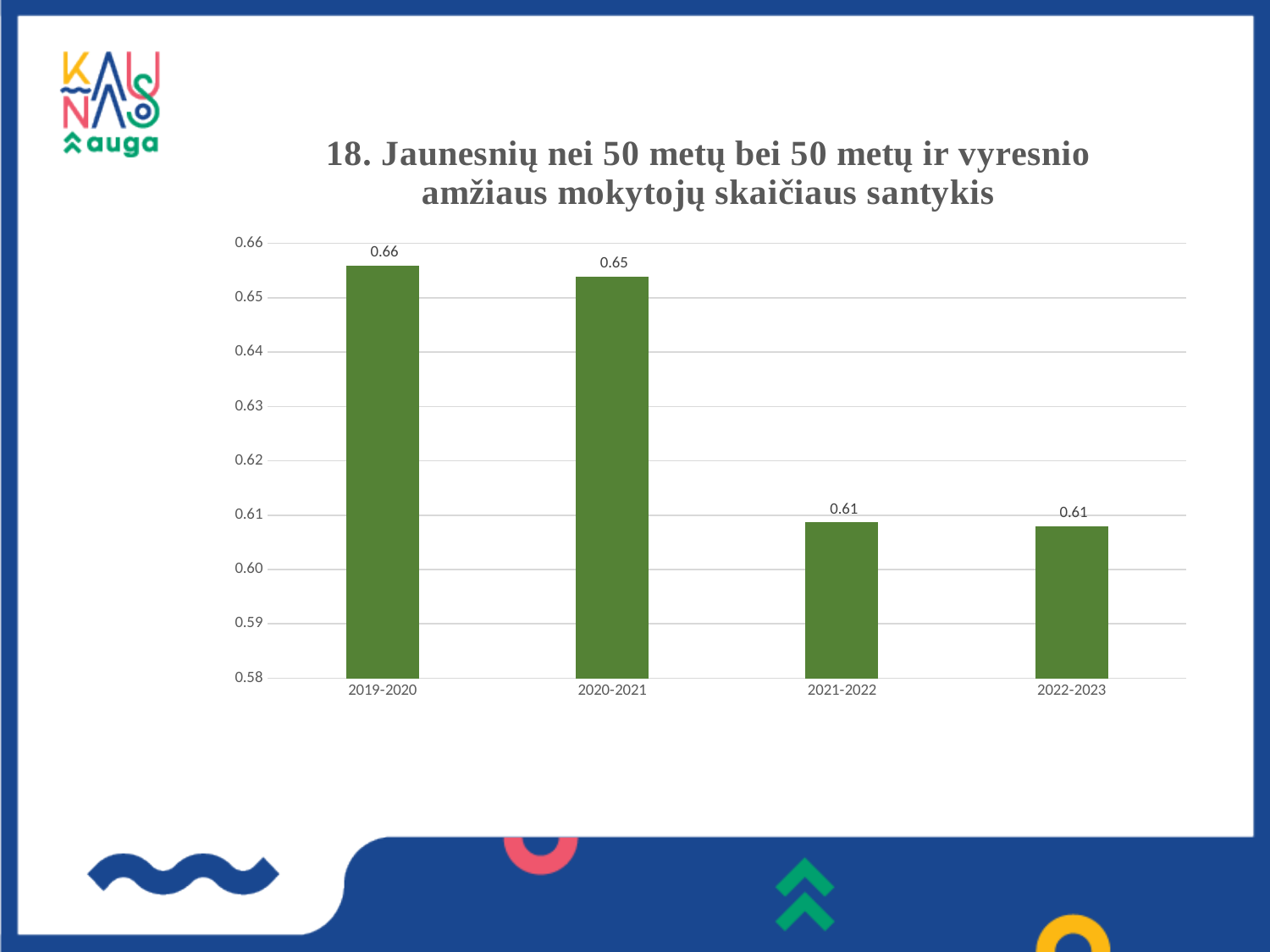
What is the value for 2019-2020? 0.66 What is the difference between the values for 2019-2020 and 2020-2021? 0.01 What is the difference between the values for 2019-2020 and 2022-2023? 0.05 What is the value for 2021-2022? 0.61 What kind of chart is shown on the slide? bar chart Which is larger, the value for 2020-2021 or the value for 2021-2022? 2020-2021 How many school years are shown on the x axis? 4 What is the value for 2022-2023? 0.61 What is the value for 2020-2021? 0.65 Do the values rise or fall from 2019-2020 to 2022-2023? fall Which school year has the highest value? 2019-2020 Is the value for 2021-2022 greater or less than 0.63? less